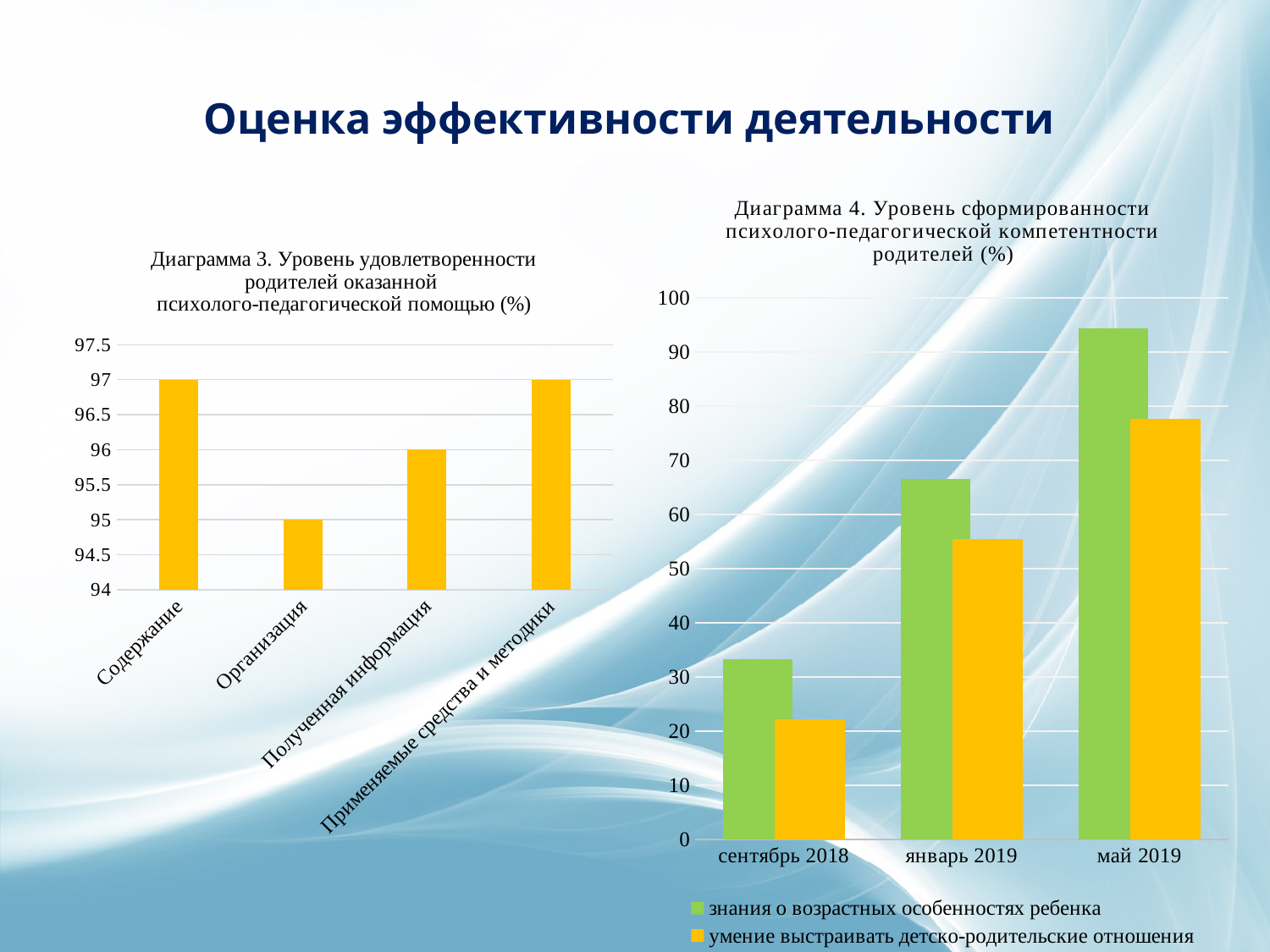
In the chart 'Диаграмма 4. Уровень сформированности психолого-педагогической компетентности родителей (%)', do the values for 'знания о возрастных особенностях ребенка' rise or fall from сентябрь 2018 to май 2019? rise In the chart 'Диаграмма 3. Уровень удовлетворенности родителей оказанной психолого-педагогической помощью (%)', which is larger: Полученная информация or Организация? Полученная информация What kind of chart is 'Диаграмма 4. Уровень сформированности психолого-педагогической компетентности родителей (%)'? bar chart In the chart 'Диаграмма 4. Уровень сформированности психолого-педагогической компетентности родителей (%)', which series is shown in green? знания о возрастных особенностях ребенка In the chart 'Диаграмма 4. Уровень сформированности психолого-педагогической компетентности родителей (%)', how many series does the legend list? 2 In the chart 'Диаграмма 3. Уровень удовлетворенности родителей оказанной психолого-педагогической помощью (%)', what is the difference between the values for Содержание and Организация? 2 In the chart 'Диаграмма 3. Уровень удовлетворенности родителей оказанной психолого-педагогической помощью (%)', what is the value for Организация? 95 In the chart 'Диаграмма 3. Уровень удовлетворенности родителей оказанной психолого-педагогической помощью (%)', what is the value for Полученная информация? 96 In the chart 'Диаграмма 3. Уровень удовлетворенности родителей оказанной психолого-педагогической помощью (%)', which category has the lowest value? Организация In the chart 'Диаграмма 3. Уровень удовлетворенности родителей оказанной психолого-педагогической помощью (%)', how many categories are shown? 4 In the chart 'Диаграмма 4. Уровень сформированности психолого-педагогической компетентности родителей (%)', is the value for 'знания о возрастных особенностях ребенка' in май 2019 greater or less than 90? greater In the chart 'Диаграмма 4. Уровень сформированности психолого-педагогической компетентности родителей (%)', is the value for 'умение выстраивать детско-родительские отношения' in сентябрь 2018 greater or less than 30? less